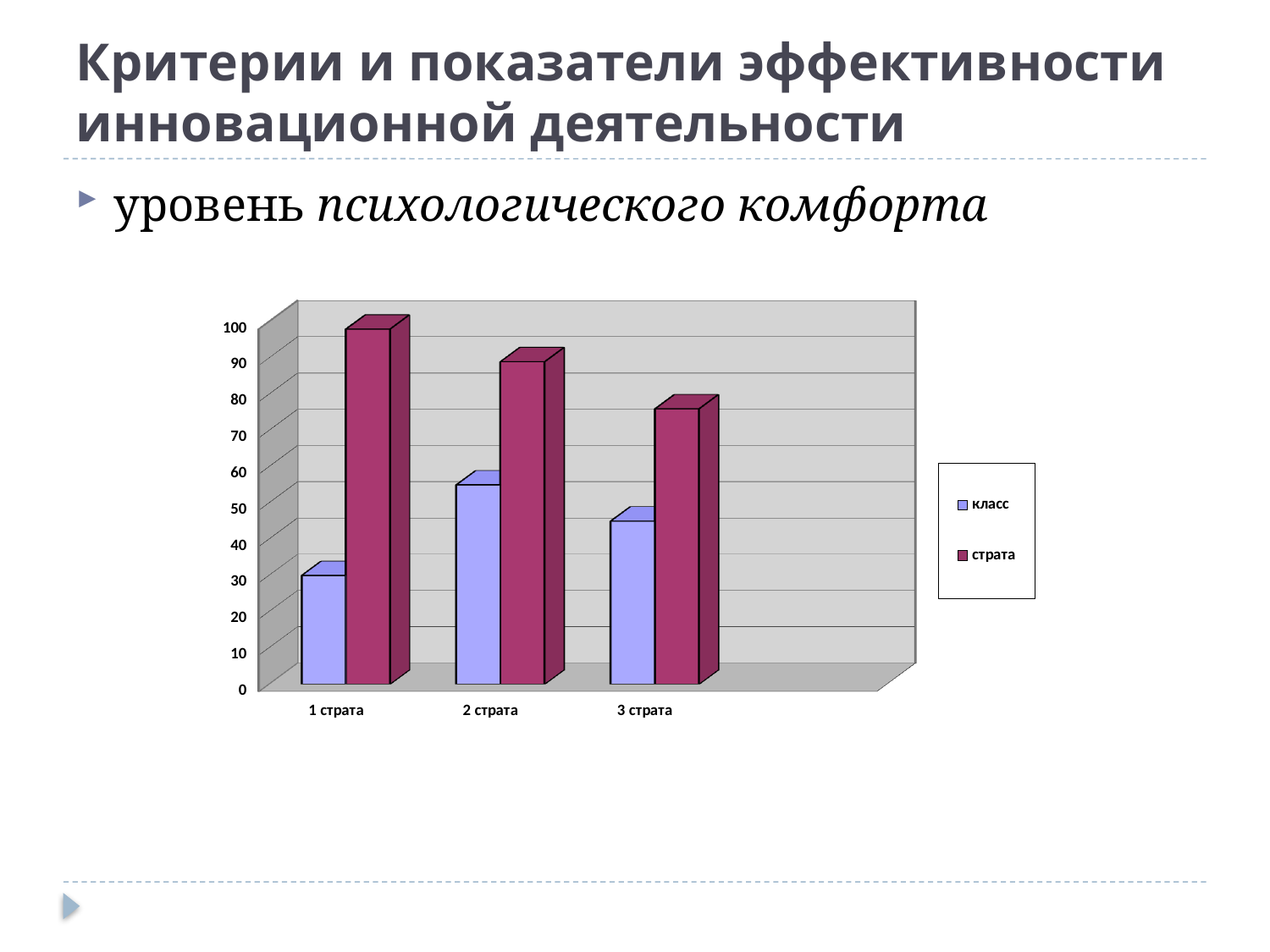
How many series does the legend list? 2 Is the value for страта in 1 страта greater or less than 90? greater Is the value for страта in 3 страта greater or less than 70? greater Which is larger in 2 страта, the класс value or the страта value? страта Do the values for the страта series rise or fall from 1 страта to 3 страта? fall Which category has the lowest value for the класс series? 1 страта Is the value for класс in 1 страта greater or less than 40? less Which category has the highest value for the страта series? 1 страта How many categories are shown on the x axis? 3 Which category has the highest value for the класс series? 2 страта What kind of chart is shown on the slide? bar chart Which category has the lowest value for the страта series? 3 страта